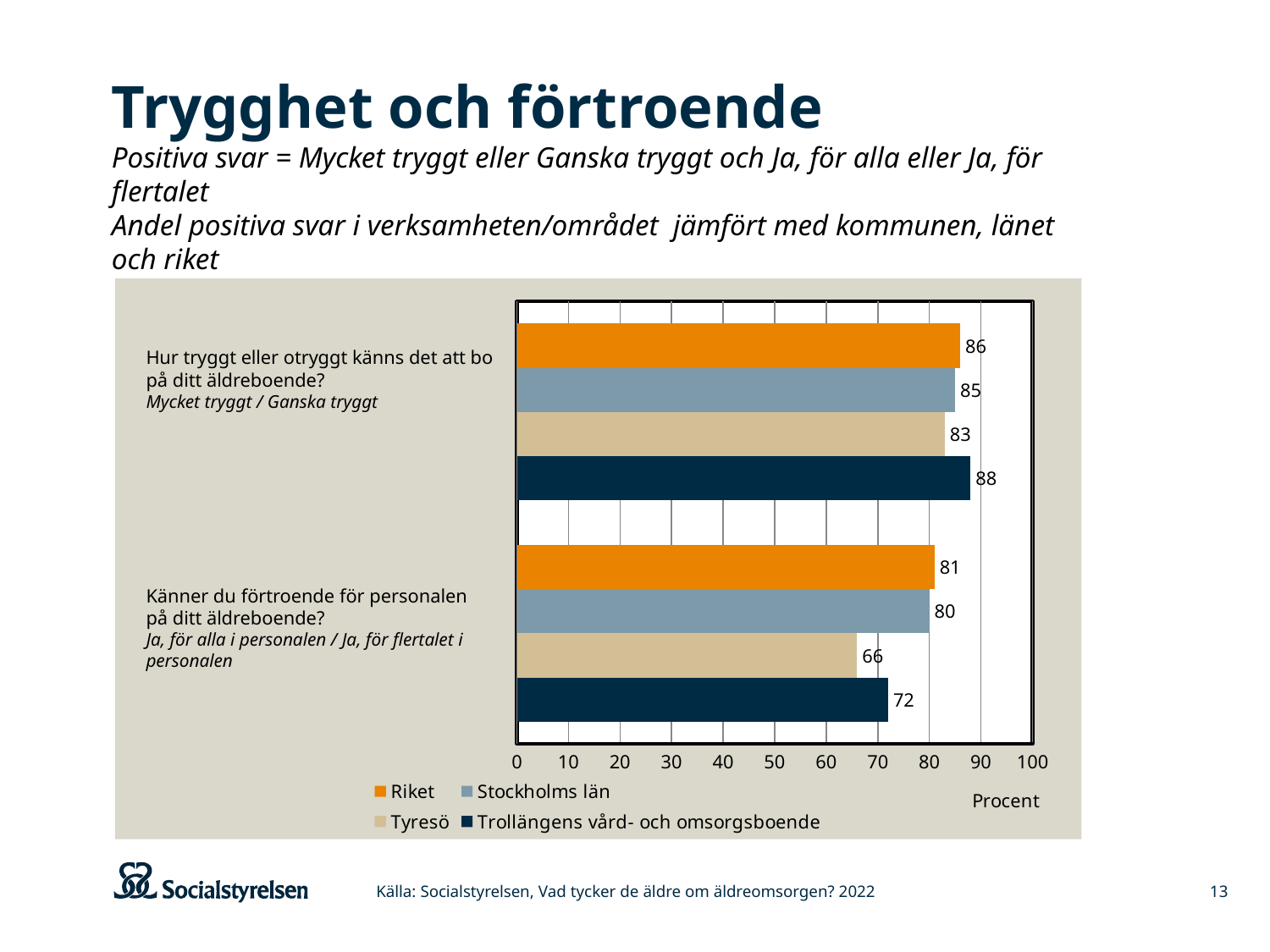
What is the value for Riket on the question "Hur tryggt eller otryggt känns det att bo på ditt äldreboende?"? 86 What is the difference between Riket and Tyresö on the question "Känner du förtroende för personalen på ditt äldreboende?"? 15 How many question categories are shown on the chart? 2 How many series does the legend list? 4 What is the value for Trollängens vård- och omsorgsboende on the question "Hur tryggt eller otryggt känns det att bo på ditt äldreboende?"? 88 Which series has the lowest value on the question "Känner du förtroende för personalen på ditt äldreboende?"? Tyresö What is the value for Tyresö on the question "Känner du förtroende för personalen på ditt äldreboende?"? 66 What kind of chart is shown on the slide? Bar chart What is the value for Stockholms län on the question "Känner du förtroende för personalen på ditt äldreboende?"? 80 Which series has the highest value on the question "Hur tryggt eller otryggt känns det att bo på ditt äldreboende?"? Trollängens vård- och omsorgsboende On the question "Känner du förtroende för personalen på ditt äldreboende?", which is larger: Riket or Trollängens vård- och omsorgsboende? Riket What is the label on the horizontal axis of the chart? Procent